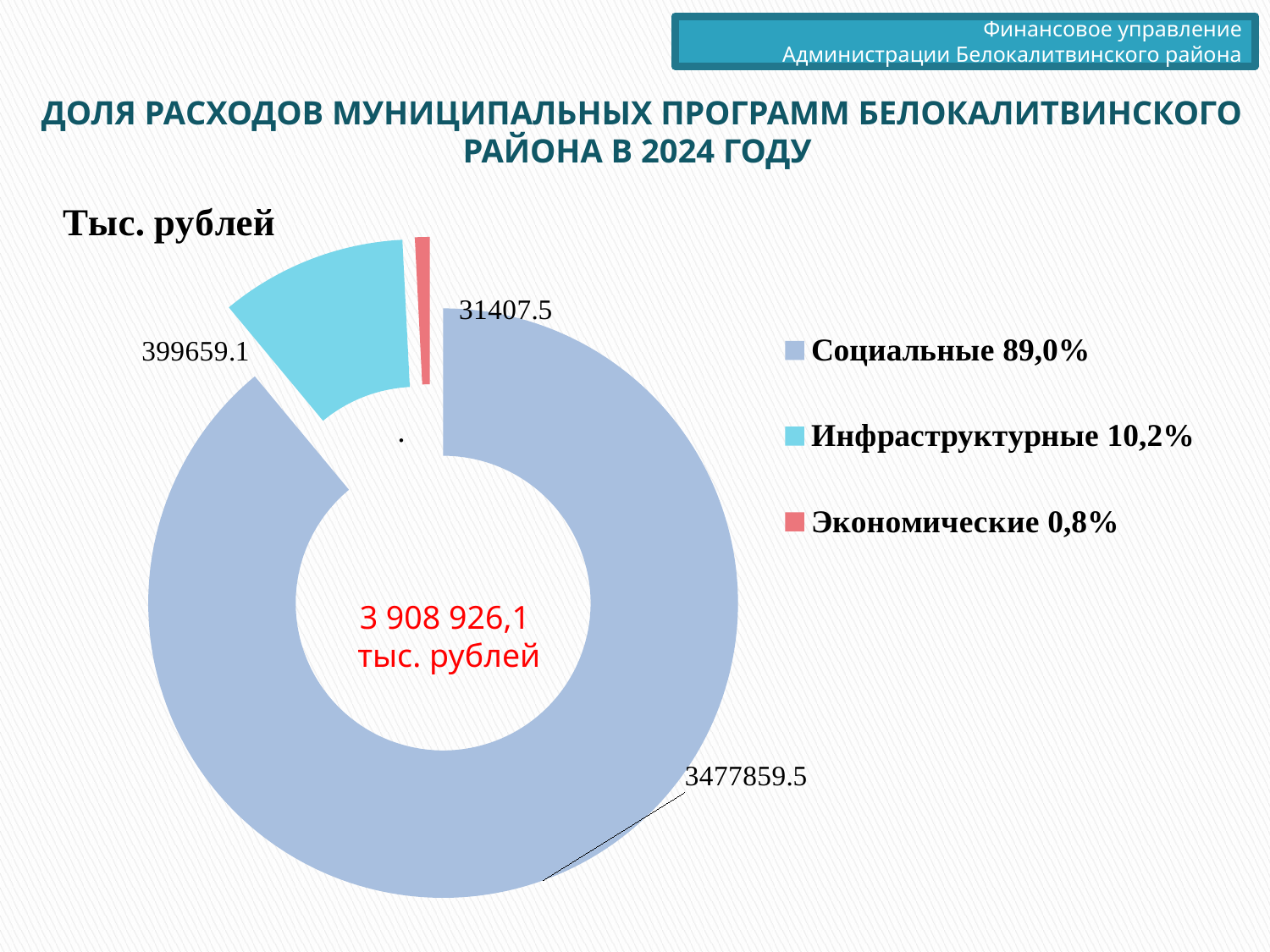
Which category has the smallest share of expenditures? Экономические What is the value for Социальные programs? 3477859.5 Which is larger, the value for Инфраструктурные or Экономические programs? Инфраструктурные What total amount is shown in the centre of the chart? 3 908 926,1 тыс. рублей What share of the chart do Инфраструктурные programs account for? 10,2% Which category has the largest share of expenditures? Социальные What type of chart is shown on the slide? Doughnut (pie) chart What is the value for Экономические programs? 31407.5 What is the value for Инфраструктурные programs? 399659.1 What share of the chart do Социальные programs account for? 89,0% What is the difference between the values for Социальные and Инфраструктурные programs? 3078200.4 How many categories does the chart show? 3